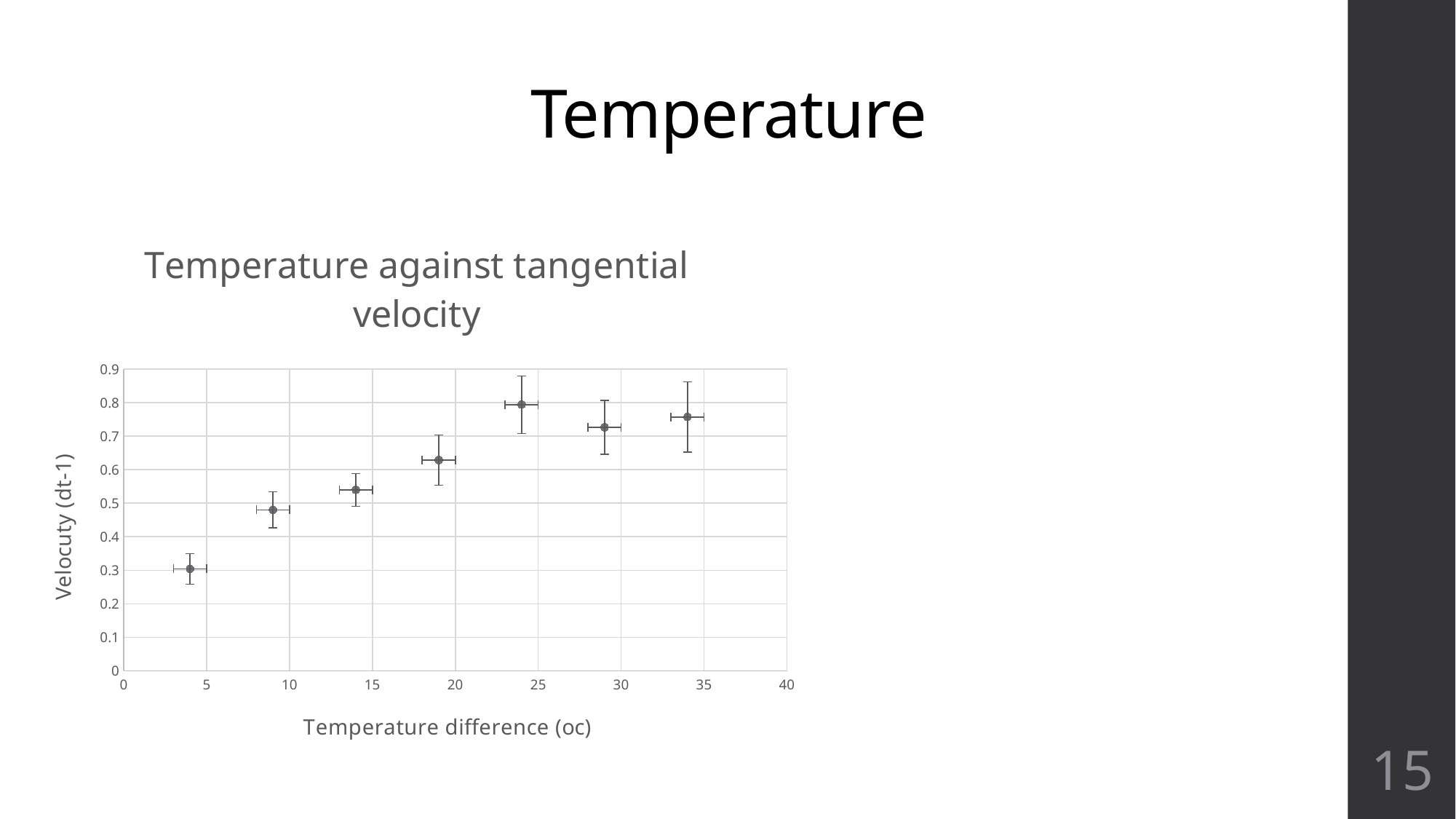
Is the velocity of the rightmost data point greater or less than 0.7? greater What kind of chart is shown on the slide? scatter chart Is the velocity of the leftmost data point greater or less than 0.4? less What is the label of the x axis? Temperature difference (oc) Is the velocity of the data point nearest a temperature difference of 25 greater or less than 0.7? greater Which data point has the lowest velocity: the leftmost point or the rightmost point? the leftmost point Does velocity generally rise or fall as temperature difference increases from 0 to 25? rise How many data points are plotted on the chart? 7 What is the highest value shown on the y axis? 0.9 Which has the higher velocity: the second data point from the left or the third data point from the left? the third data point from the left What is the title of the chart? Temperature against tangential velocity